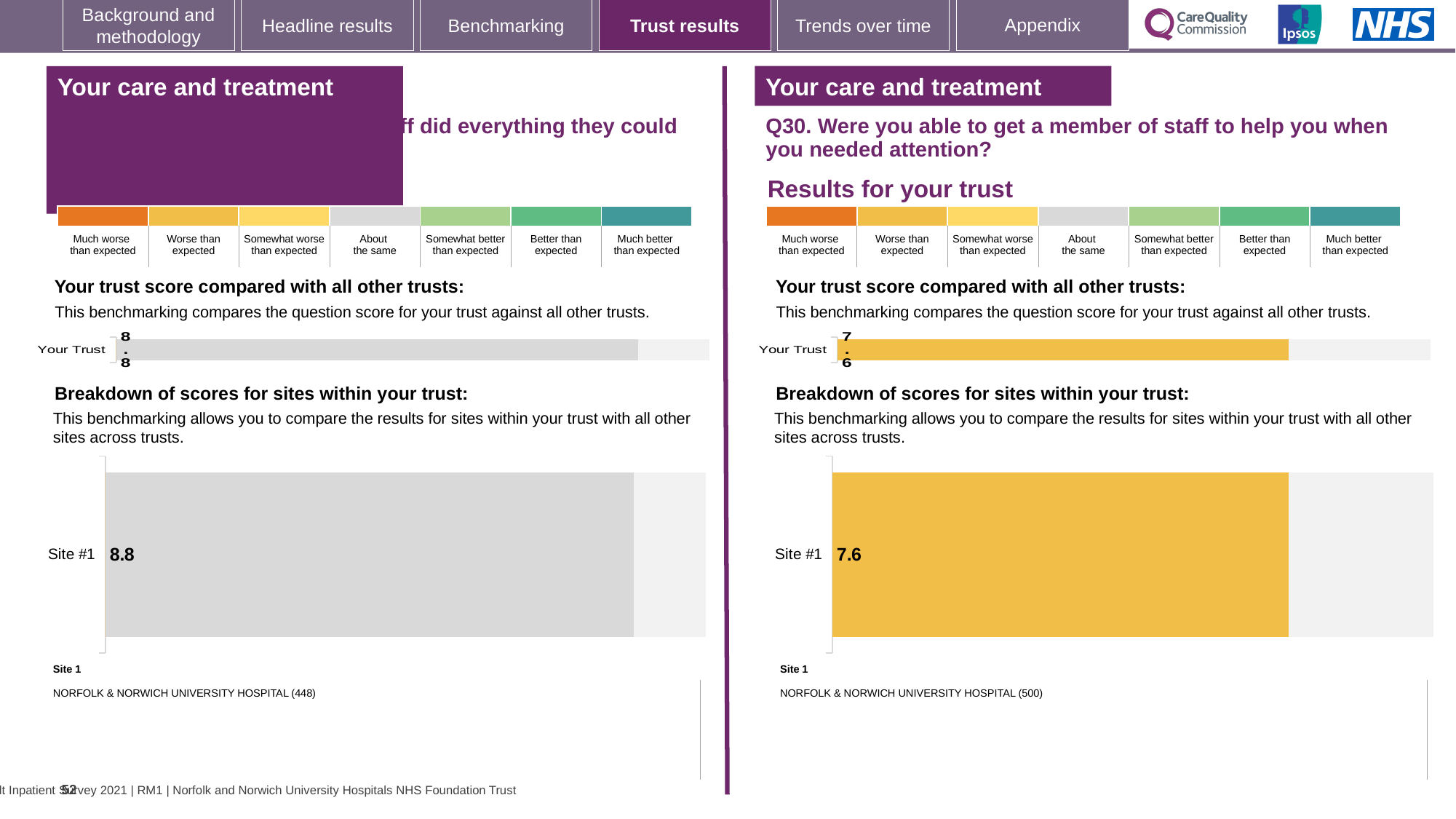
On the left-hand side of the slide, what is the score shown for Your Trust? 8.8 On the right-hand side of the slide (Q30), which benchmark category does the colour of the Your Trust bar correspond to? Worse than expected Which is larger: the Site #1 score on the left-hand side of the slide or the Site #1 score on the right-hand side (Q30)? Left-hand side (8.8) On the right-hand side of the slide (Q30), what is the score shown for Your Trust? 7.6 What is the difference between the Site #1 score on the left-hand side of the slide and the Site #1 score on the right-hand side (Q30)? 1.2 On the left-hand side of the slide, which benchmark category does the colour of the Your Trust bar correspond to? About the same On the right-hand side of the slide (Q30), what is the score shown for Site #1? 7.6 On the left-hand side of the slide, what is the score shown for Site #1? 8.8 Which site name is listed as Site 1 on the right-hand side of the slide (Q30)? NORFOLK & NORWICH UNIVERSITY HOSPITAL (500) How many sites are shown in the 'Breakdown of scores for sites within your trust' chart on the right-hand side of the slide (Q30)? 1 What kind of chart is used to show the Site #1 score on the right-hand side of the slide (Q30)? Bar chart How many sites are shown in the 'Breakdown of scores for sites within your trust' chart on the left-hand side of the slide? 1